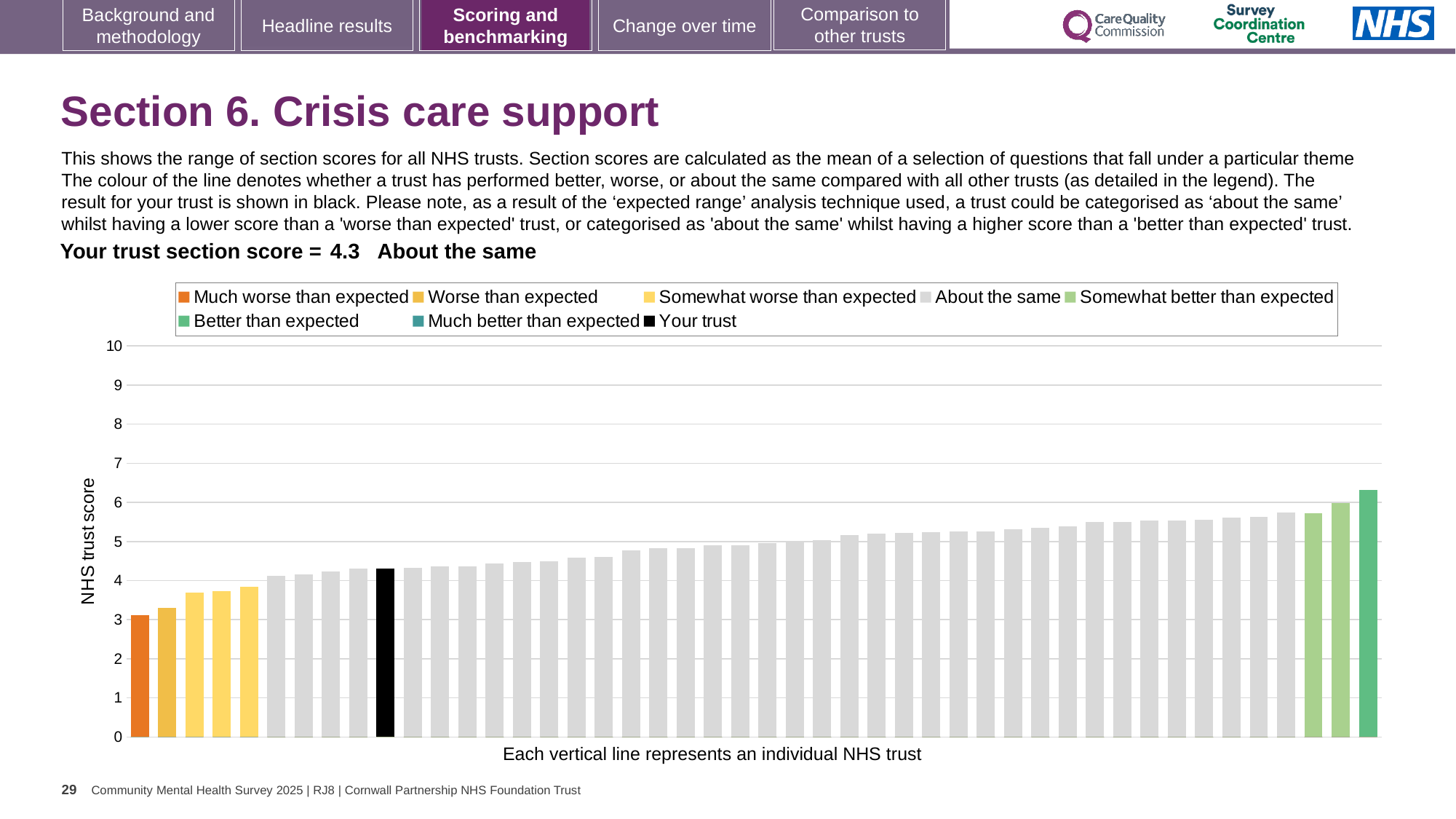
How many entries does the chart legend list? 8 Which legend category does your trust fall into? About the same What is the highest tick value shown on the vertical axis? 10 Is the value of the black 'Your trust' bar greater or less than 5? less Is the value of the shortest bar greater or less than 4? less Is the value of the tallest bar greater or less than 6? greater Which legend category does the tallest bar belong to? Better than expected What kind of chart is shown on the slide? bar chart What is the label on the vertical axis of the chart? NHS trust score What is the section score for your trust? 4.3 Which legend category does the shortest bar belong to? Much worse than expected